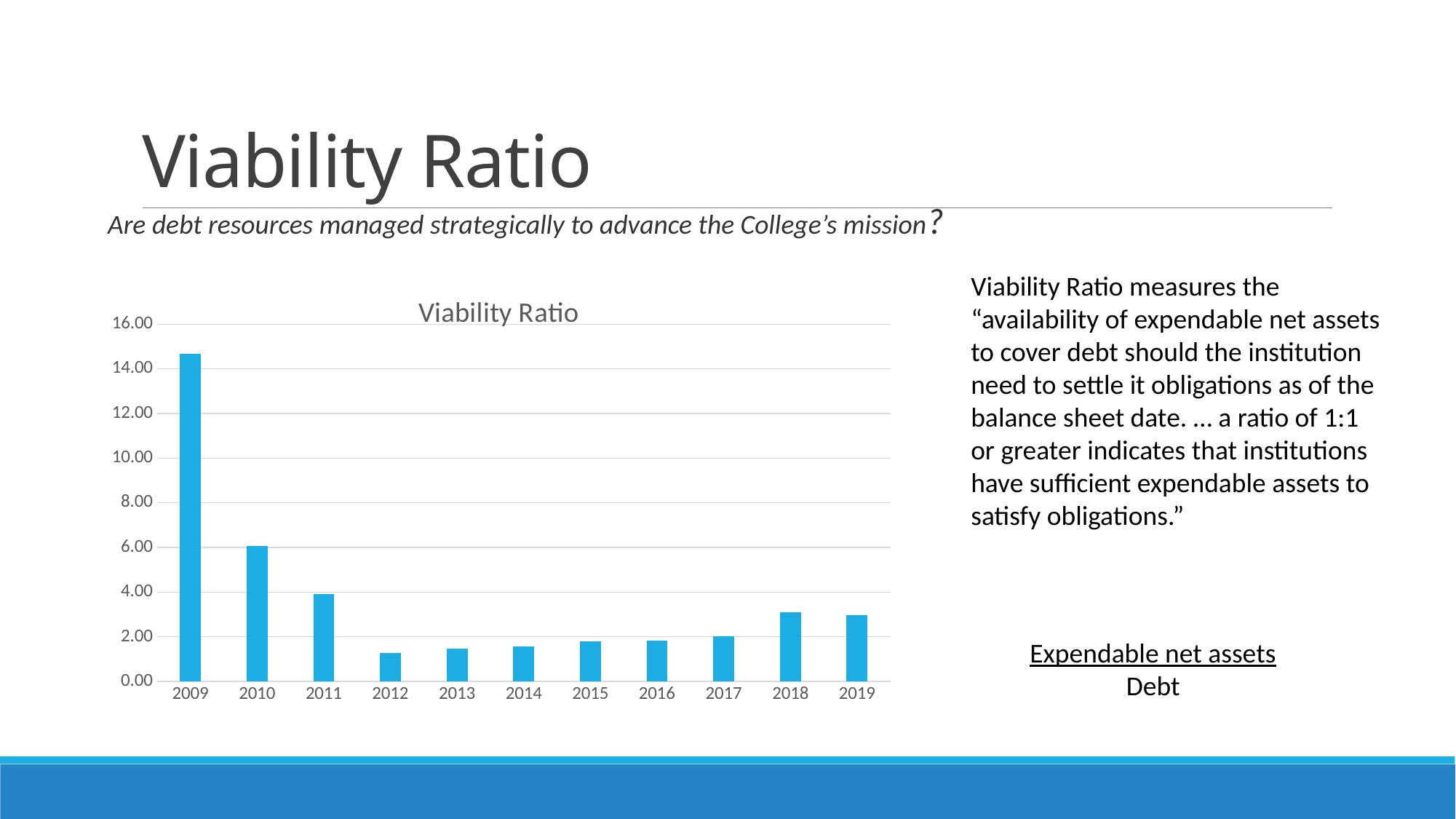
Is the value for 2010 greater or less than 4.00? greater Do the values rise or fall from 2009 to 2012? fall Is the value for 2009 greater or less than 14.00? greater Is the value for 2012 greater or less than 2.00? less Which year has the larger viability ratio, 2009 or 2010? 2009 Which year has the lowest viability ratio? 2012 What kind of chart is shown on the slide? bar chart What is the title of the chart? Viability Ratio Which year has the larger viability ratio, 2012 or 2018? 2018 How many years are shown on the x axis of the chart? 11 Which year has the highest viability ratio? 2009